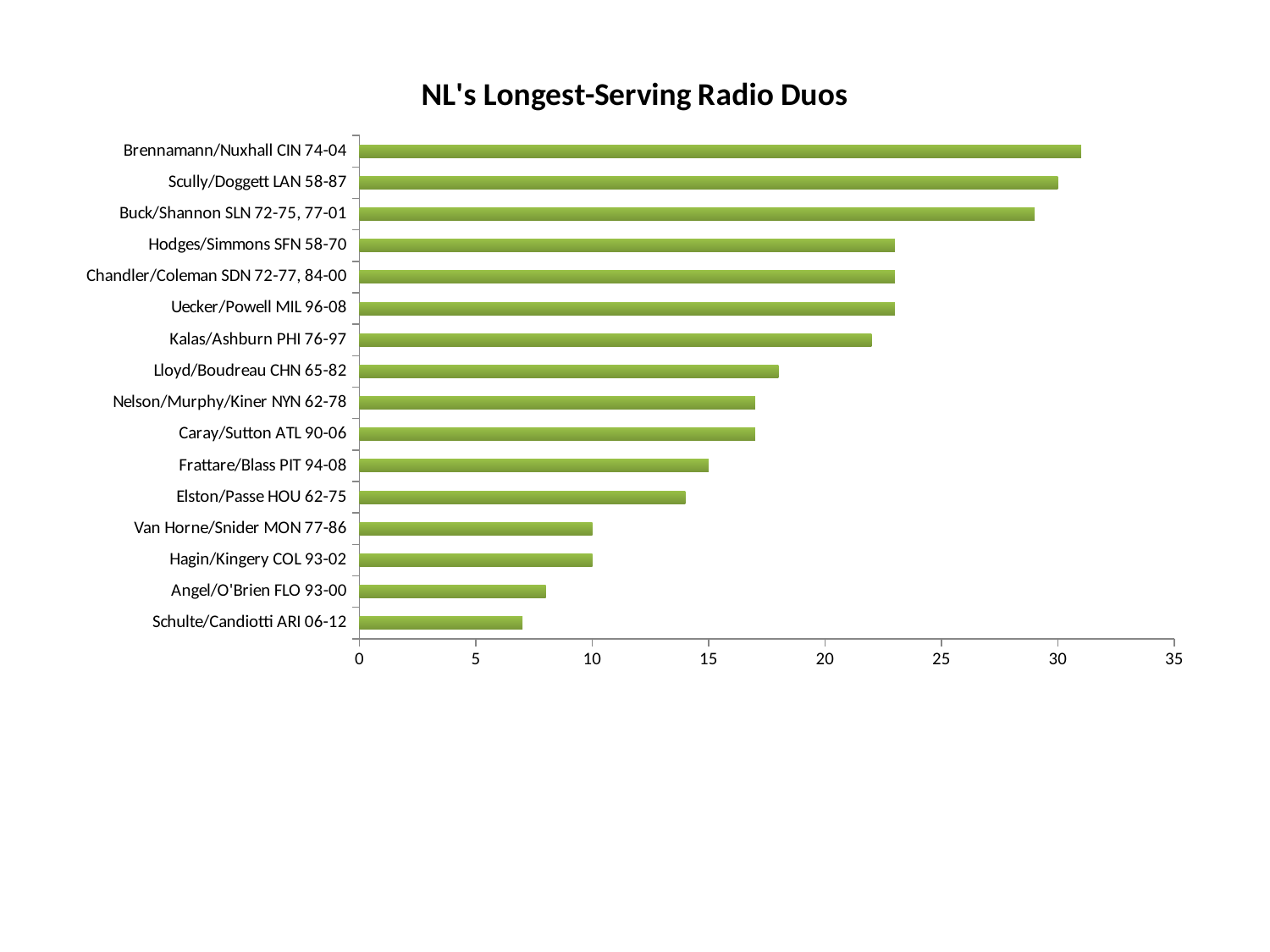
How many radio duos are listed on the chart? 16 What is the title of the chart? NL's Longest-Serving Radio Duos Which has the larger value, Kalas/Ashburn PHI 76-97 or Lloyd/Boudreau CHN 65-82? Kalas/Ashburn PHI 76-97 Which radio duo has the longest bar? Brennamann/Nuxhall CIN 74-04 What is the value for Frattare/Blass PIT 94-08? 15 What is the value for Van Horne/Snider MON 77-86? 10 Which radio duo has the shortest bar? Schulte/Candiotti ARI 06-12 What is the value for Scully/Doggett LAN 58-87? 30 Is the value for Brennamann/Nuxhall CIN 74-04 greater or less than 30? greater What kind of chart is shown on the slide? bar chart Is the value for Schulte/Candiotti ARI 06-12 greater or less than 10? less Is the value for Kalas/Ashburn PHI 76-97 greater or less than 20? greater